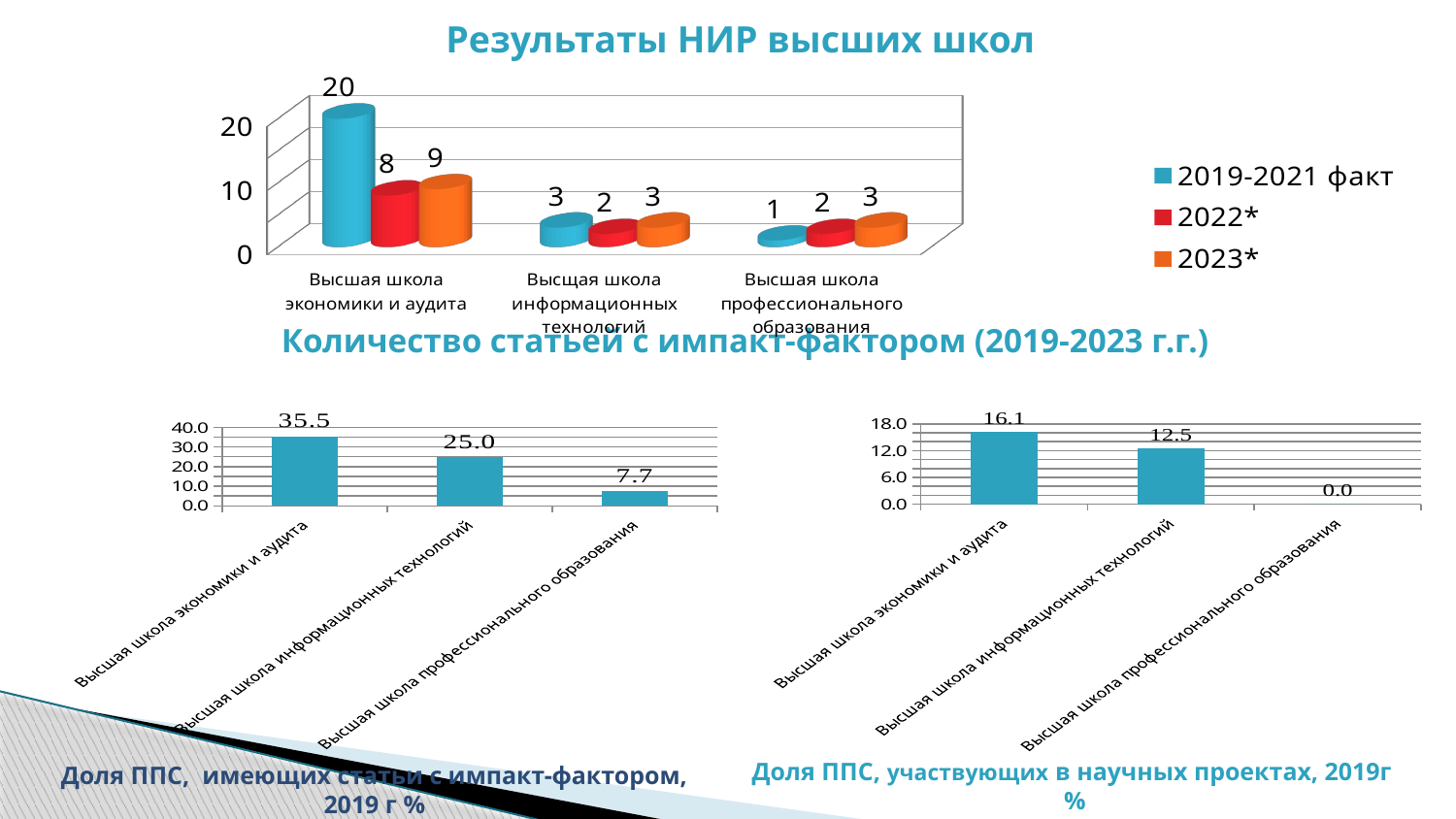
In the bottom-left chart 'Доля ППС, имеющих статьи с импакт-фактором, 2019 г %', what is the value for Высшая школа информационных технологий? 25.0 In the top chart 'Количество статьей с импакт-фактором (2019-2023 г.г.)', how many series does the legend list? 3 In the top chart 'Количество статьей с импакт-фактором (2019-2023 г.г.)', what colour are the bars for the series 2022*? Red What kind of chart is the bottom-right chart 'Доля ППС, участвующих в научных проектах, 2019г %'? Bar chart In the bottom-right chart 'Доля ППС, участвующих в научных проектах, 2019г %', what is the value for Высшая школа экономики и аудита? 16.1 In the top chart 'Количество статьей с импакт-фактором (2019-2023 г.г.)', what is the value for Высшая школа профессионального образования in the series 2022*? 2 In the top chart 'Количество статьей с импакт-фактором (2019-2023 г.г.)', what is the value for Высшая школа экономики и аудита in the series 2019-2021 факт? 20 In the top chart 'Количество статьей с импакт-фактором (2019-2023 г.г.)', which category has the highest value in the series 2023*? Высшая школа экономики и аудита In the bottom-left chart 'Доля ППС, имеющих статьи с импакт-фактором, 2019 г %', what is the difference between the values for Высшая школа экономики и аудита and Высшая школа информационных технологий? 10.5 In the bottom-left chart 'Доля ППС, имеющих статьи с импакт-фактором, 2019 г %', which category has the lowest value? Высшая школа профессионального образования In the top chart 'Количество статьей с импакт-фактором (2019-2023 г.г.)', what is the difference between the 2019-2021 факт value and the 2022* value for Высшая школа экономики и аудита? 12 In the bottom-right chart 'Доля ППС, участвующих в научных проектах, 2019г %', how many categories are shown? 3